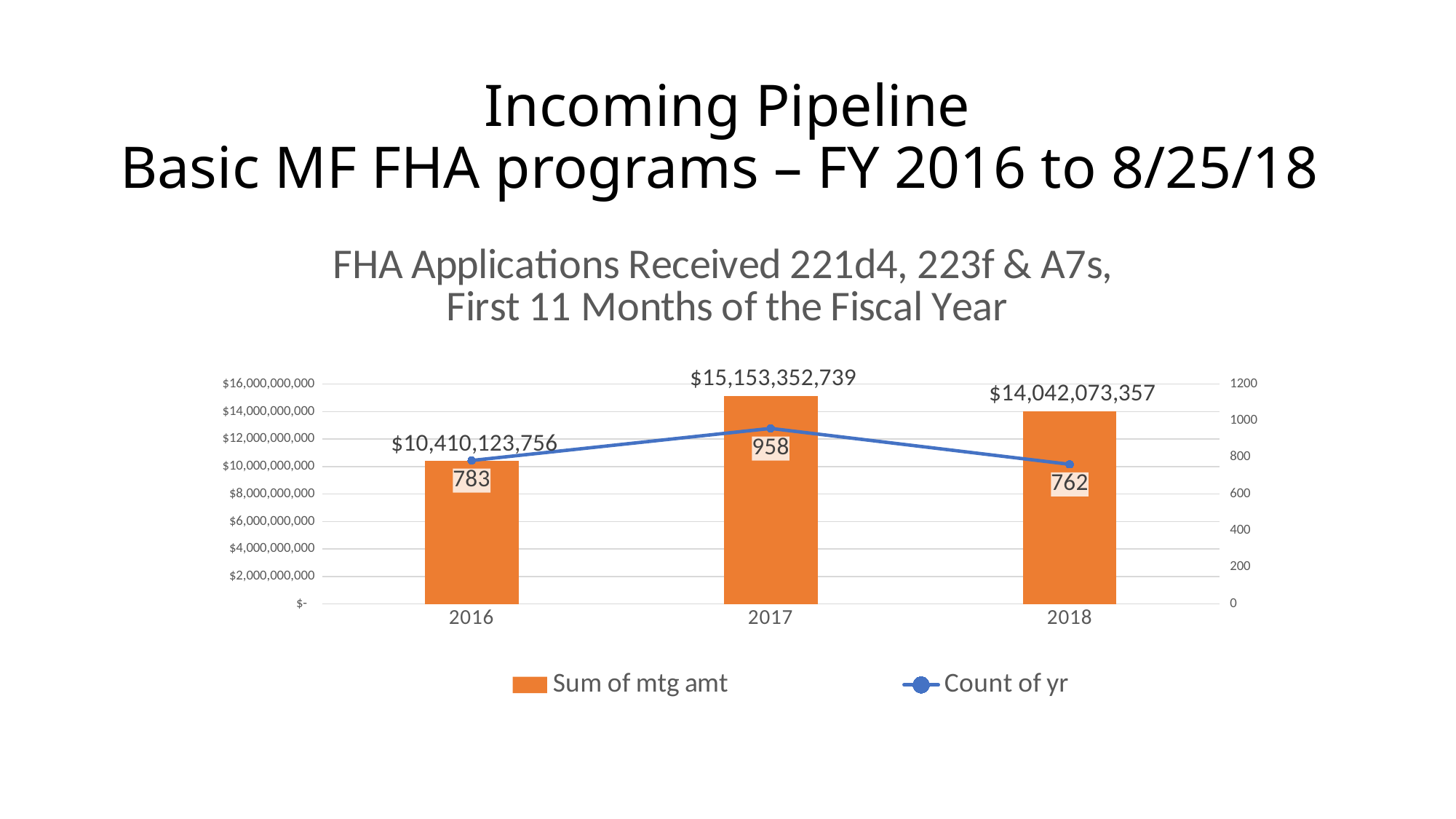
What is the Count of yr for 2016? 783 What is the difference between the Count of yr for 2017 and 2018? 196 Which year has a larger Count of yr, 2016 or 2018? 2016 What is the difference between the Sum of mtg amt for 2017 and 2018? $1,111,279,382 How many series does the legend list? 2 What is the title of the chart? FHA Applications Received 221d4, 223f & A7s, First 11 Months of the Fiscal Year What is the Sum of mtg amt for 2017? $15,153,352,739 Which year has the lowest Sum of mtg amt? 2016 What is the Sum of mtg amt for 2018? $14,042,073,357 How many years are shown on the x axis? 3 What kind of chart is used to show the Sum of mtg amt series? Bar chart Which year has the highest Count of yr? 2017